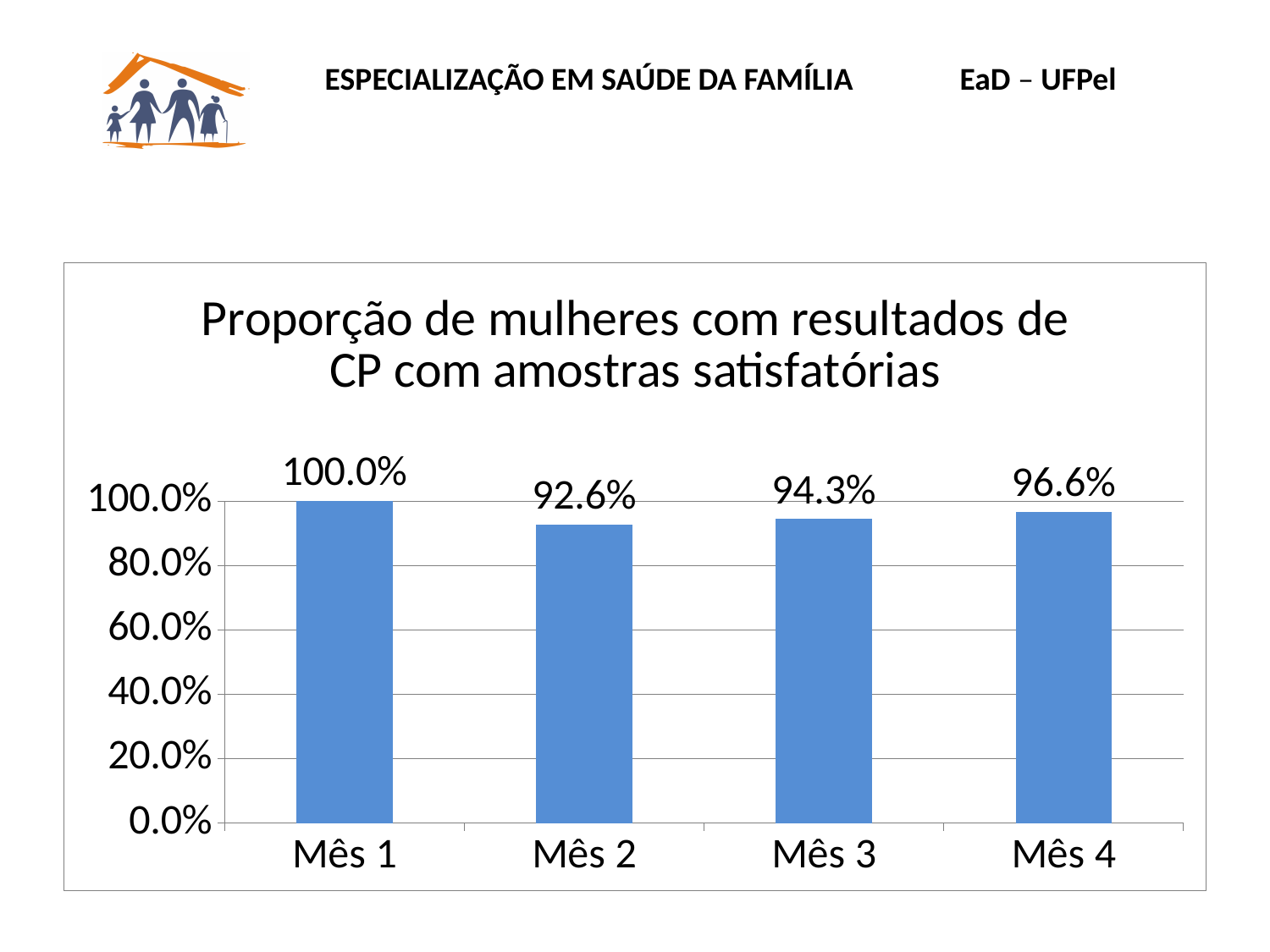
What is the title of the chart? Proporção de mulheres com resultados de CP com amostras satisfatórias What is the value for Mês 1? 100.0% How many months are shown on the x axis? 4 Which month has the highest value? Mês 1 What is the value for Mês 2? 92.6% What kind of chart is shown on the slide? Bar chart Which is larger, the value for Mês 3 or the value for Mês 4? Mês 4 Which month has the lowest value? Mês 2 What is the value for Mês 4? 96.6% What is the difference between the values for Mês 4 and Mês 3? 2.3% What is the value for Mês 3? 94.3% What is the difference between the values for Mês 1 and Mês 2? 7.4%